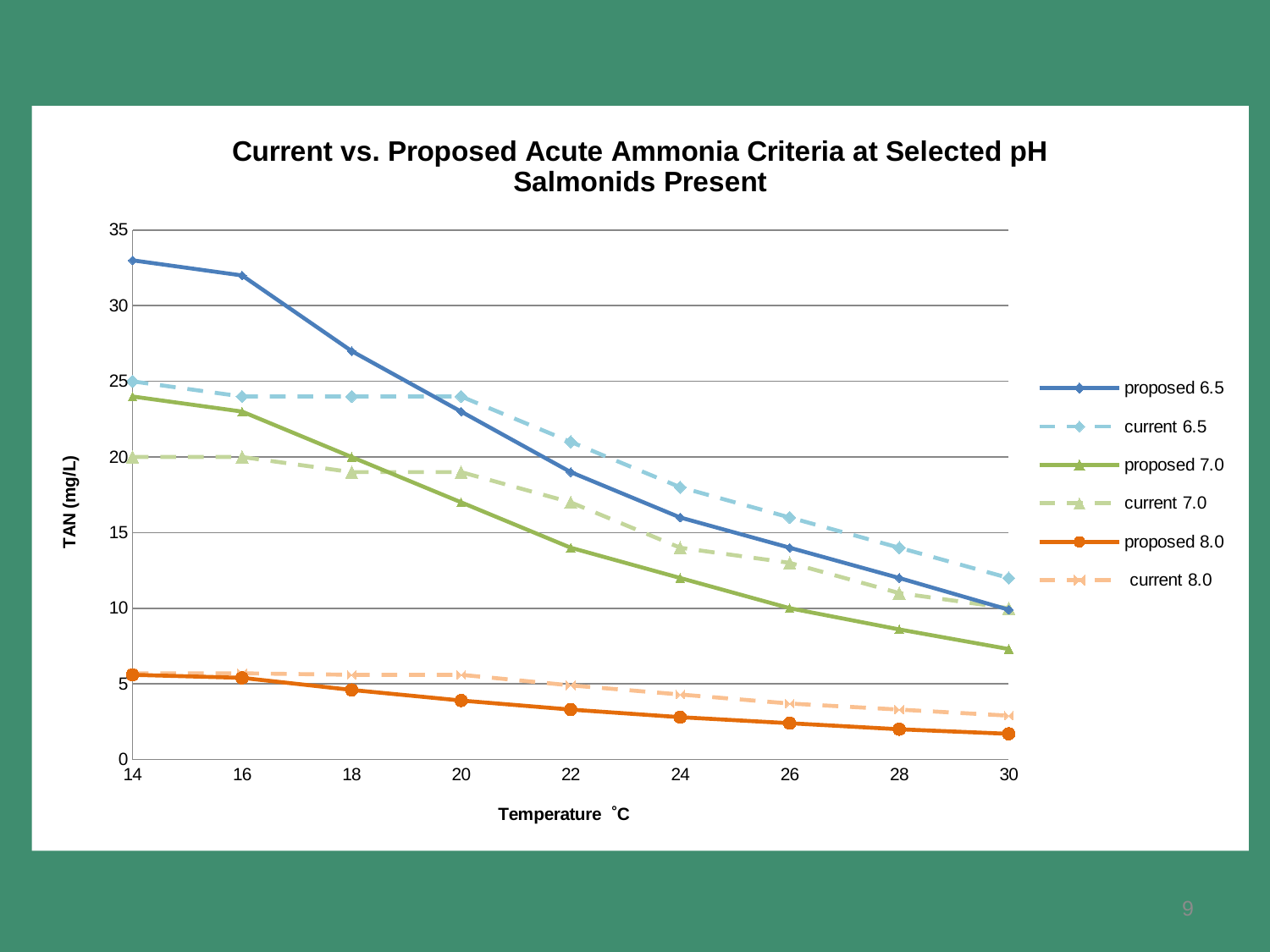
Is the value for proposed 6.5 at 14 °C greater or less than 30? greater How many temperature points are plotted along the x axis? 9 What kind of chart is shown on the slide? line chart Do the values for the proposed 6.5 series rise or fall as temperature increases? fall Which series has the highest value at 14 °C? proposed 6.5 What is the label of the y axis? TAN (mg/L) Which series is drawn with a solid orange line with circle markers? proposed 8.0 Is the value for proposed 8.0 at 30 °C greater or less than 5? less How many series does the legend list? 6 Which series has the lowest value at 30 °C? proposed 8.0 Is the value for current 6.5 at 22 °C greater or less than 20? greater At 26 °C, which is larger: current 6.5 or proposed 7.0? current 6.5